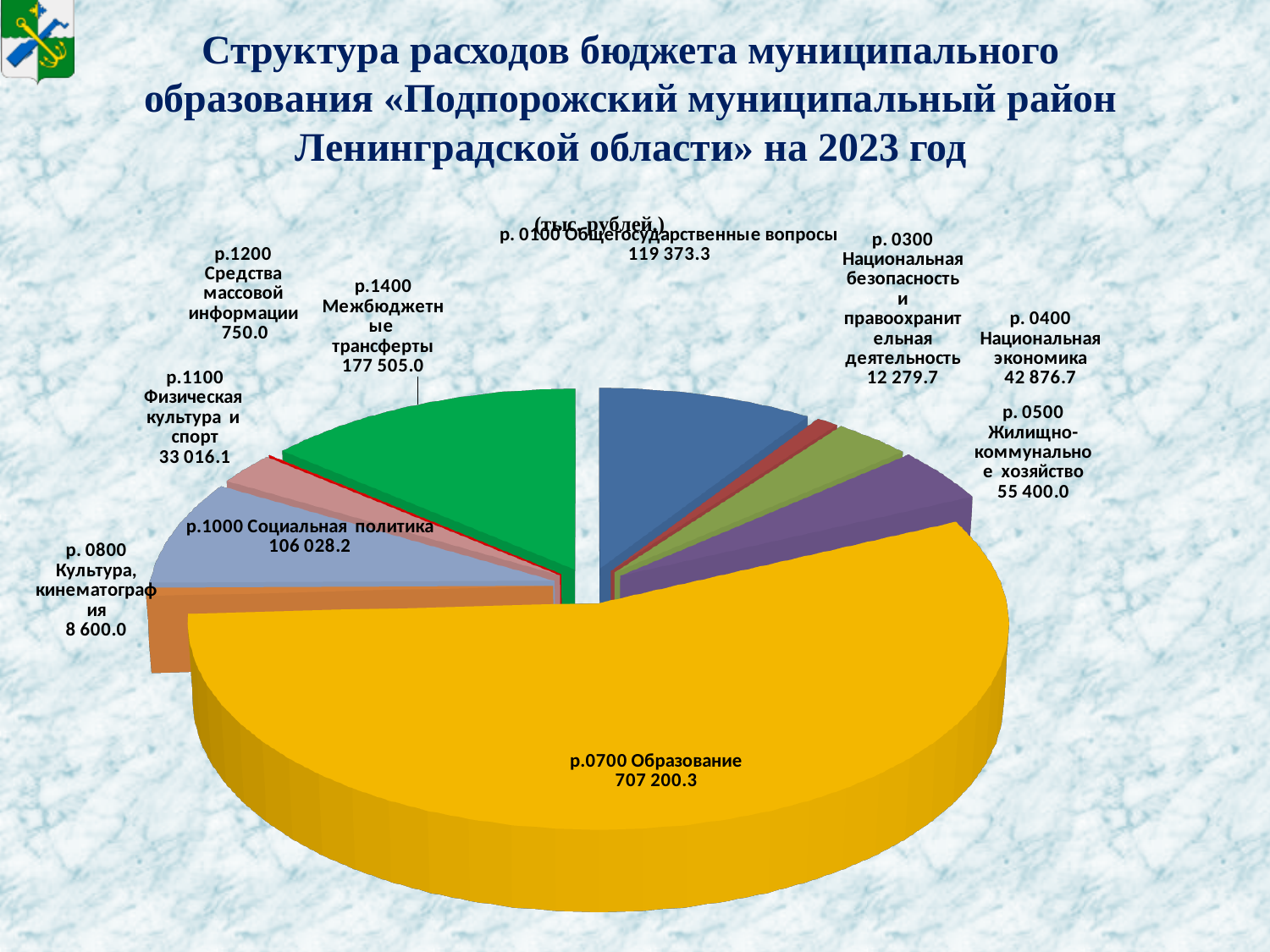
What type of chart is shown on the slide? pie chart What is the value for р.0700 Образование? 707 200.3 What is the value for р. 0500 Жилищно-коммунальное хозяйство? 55 400.0 Which category has the smallest value? р.1200 Средства массовой информации In what units are the values on the chart given? тыс. рублей What is the value for р.1400 Межбюджетные трансферты? 177 505.0 What is the difference between р. 0500 Жилищно-коммунальное хозяйство and р. 0400 Национальная экономика? 12 523.3 How many categories are shown in the pie chart? 10 What is the difference between р.0700 Образование and р.1400 Межбюджетные трансферты? 529 695.3 Which is larger: р. 0100 Общегосударственные вопросы or р.1000 Социальная политика? р. 0100 Общегосударственные вопросы What is the value for р.1200 Средства массовой информации? 750.0 Which category has the largest slice of the pie? р.0700 Образование